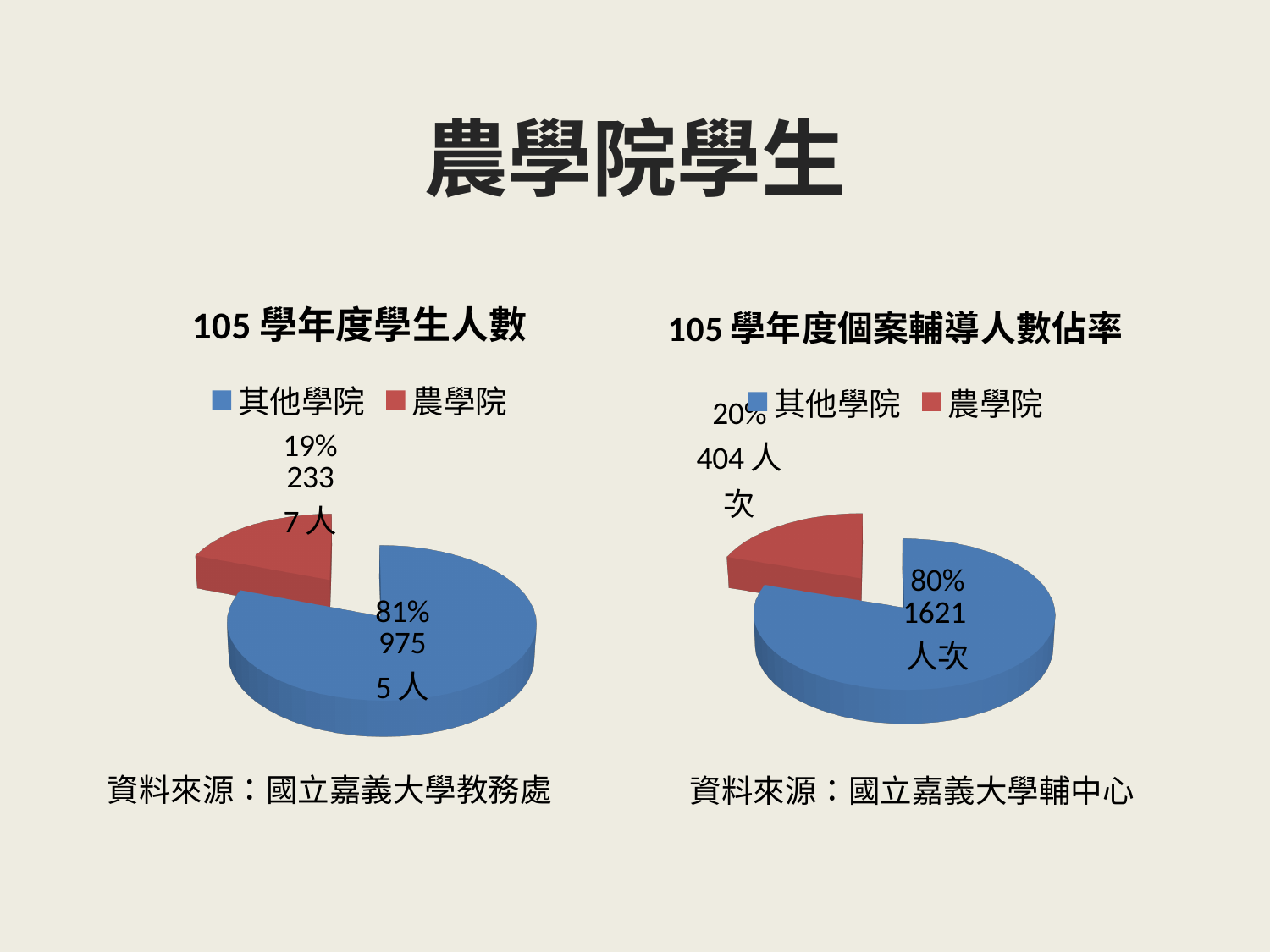
In the right chart (105 學年度個案輔導人數佔率), what is the value for 其他學院? 1621 人次 In the left chart (105 學年度學生人數), what is the number of students for 農學院? 2337 人 What kind of chart is the left chart titled 105 學年度學生人數? pie chart In the left chart (105 學年度學生人數), which category has the smallest slice? 農學院 In the right chart (105 學年度個案輔導人數佔率), what is the value for 農學院? 404 人次 In the left chart (105 學年度學生人數), what is the number of students for 其他學院? 9755 人 In the left chart (105 學年度學生人數), what percentage share does 其他學院 have? 81% How many slices does the right chart (105 學年度個案輔導人數佔率) have? 2 In the right chart (105 學年度個案輔導人數佔率), what percentage share does 農學院 have? 20% In the left chart (105 學年度學生人數), what colour is the 農學院 slice? red In the left chart (105 學年度學生人數), what percentage share does 農學院 have? 19% In the right chart (105 學年度個案輔導人數佔率), which category has the largest slice? 其他學院